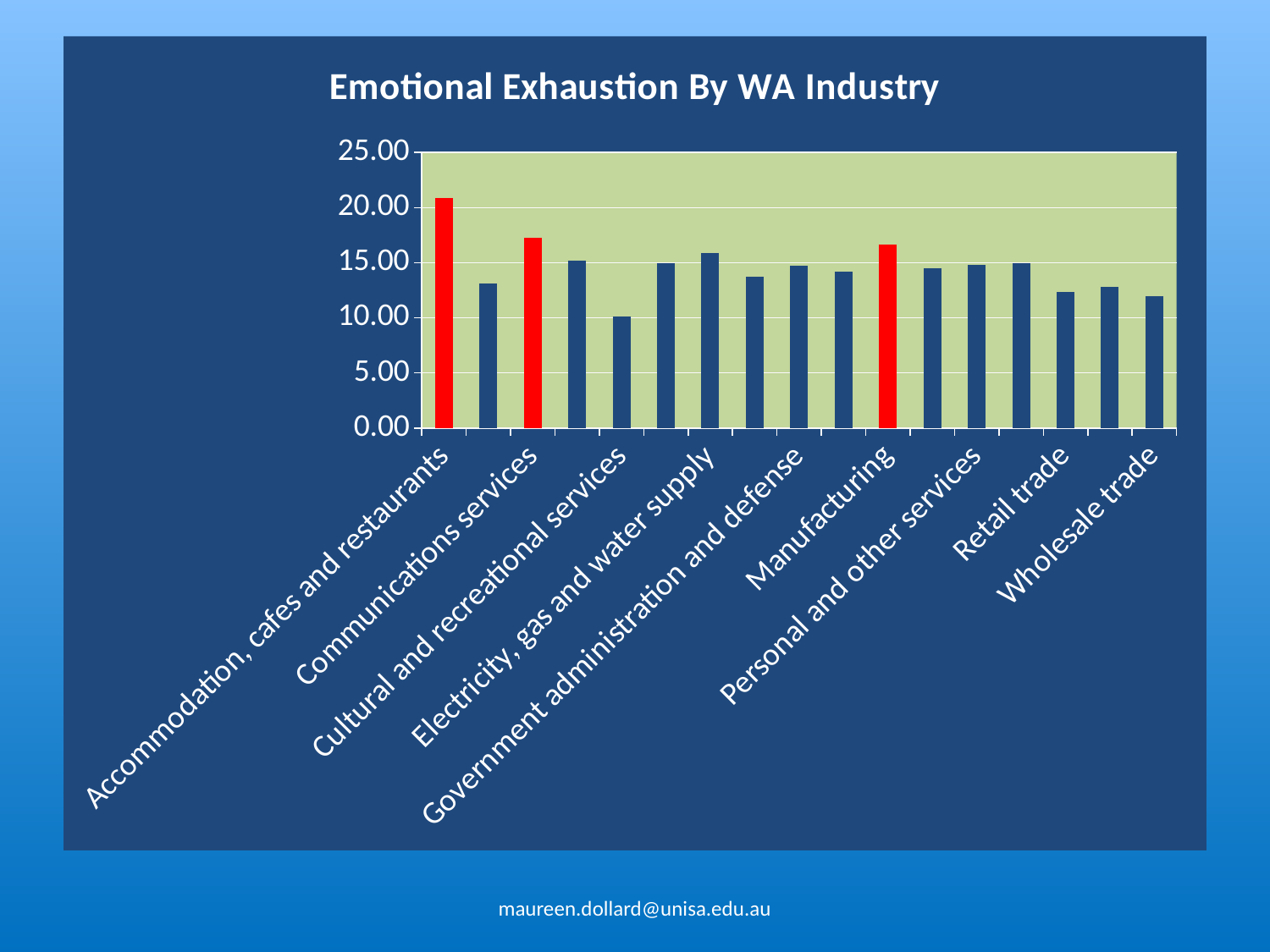
Is the value for Communications services greater or less than 15.00? greater How many bars are coloured red in the chart? 3 Which industry has the lowest emotional exhaustion value? Cultural and recreational services Which has the larger value, Accommodation, cafes and restaurants or Manufacturing? Accommodation, cafes and restaurants Is the value for Retail trade greater or less than 15.00? less Which industry has the highest emotional exhaustion value? Accommodation, cafes and restaurants Which has the larger value, Cultural and recreational services or Retail trade? Retail trade Is the value for Wholesale trade greater or less than 15.00? less What is the title of the chart? Emotional Exhaustion By WA Industry What type of chart is shown on the slide? Bar chart